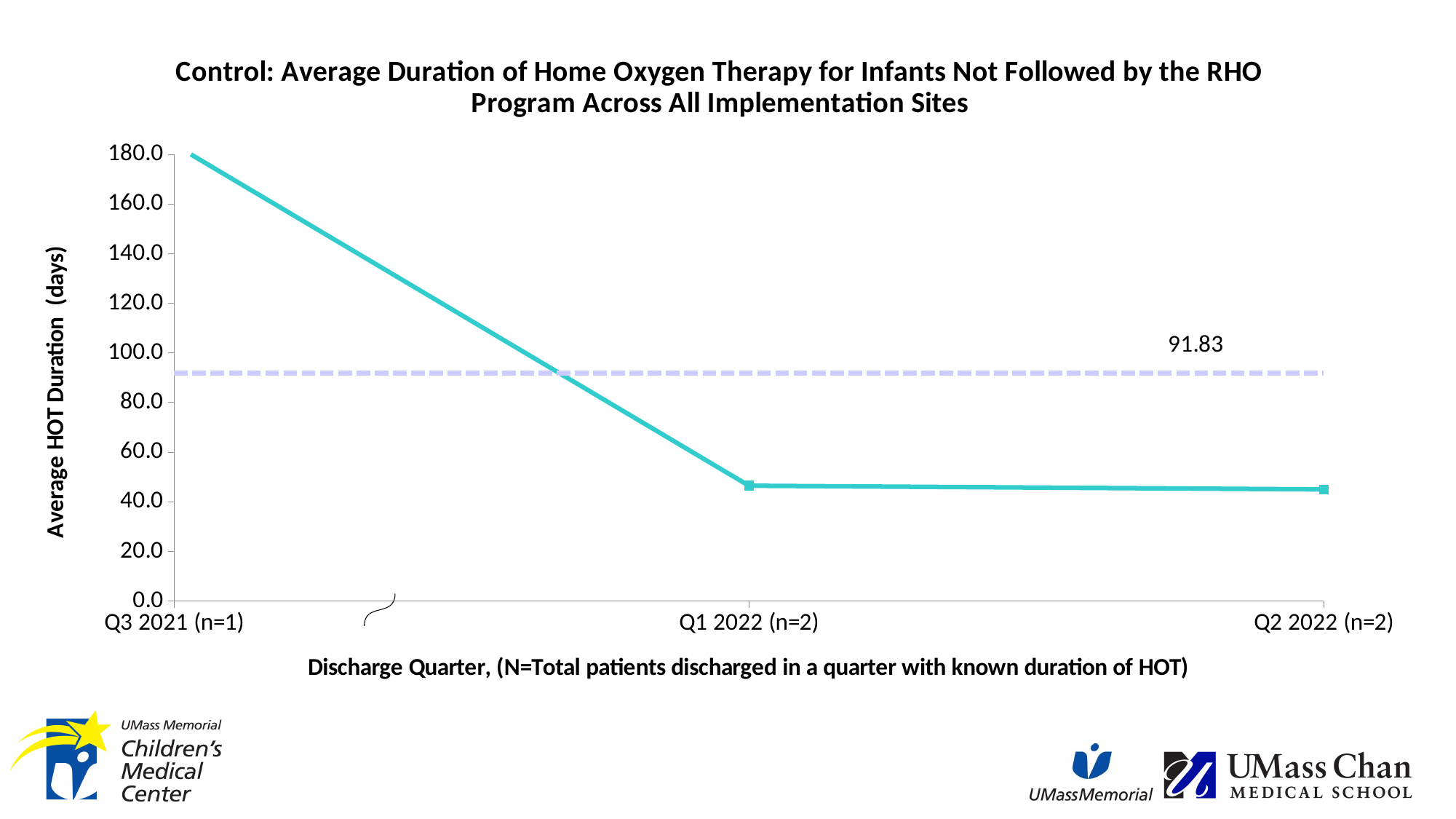
Is the value for Q1 2022 (n=2) greater or less than 60.0? less What kind of chart is shown on the slide? Line chart How many discharge quarters are plotted on the x axis? 3 What is the title of the y axis? Average HOT Duration (days) Is the value for Q3 2021 (n=1) greater or less than 100.0? greater Is the value for Q1 2022 (n=2) greater or less than 40.0? greater Do the values rise or fall from Q3 2021 to Q2 2022? fall What value is labelled on the dashed horizontal reference line? 91.83 Which is larger, the value for Q3 2021 (n=1) or the value for Q2 2022 (n=2)? Q3 2021 (n=1) Which discharge quarter has the highest average HOT duration? Q3 2021 (n=1)